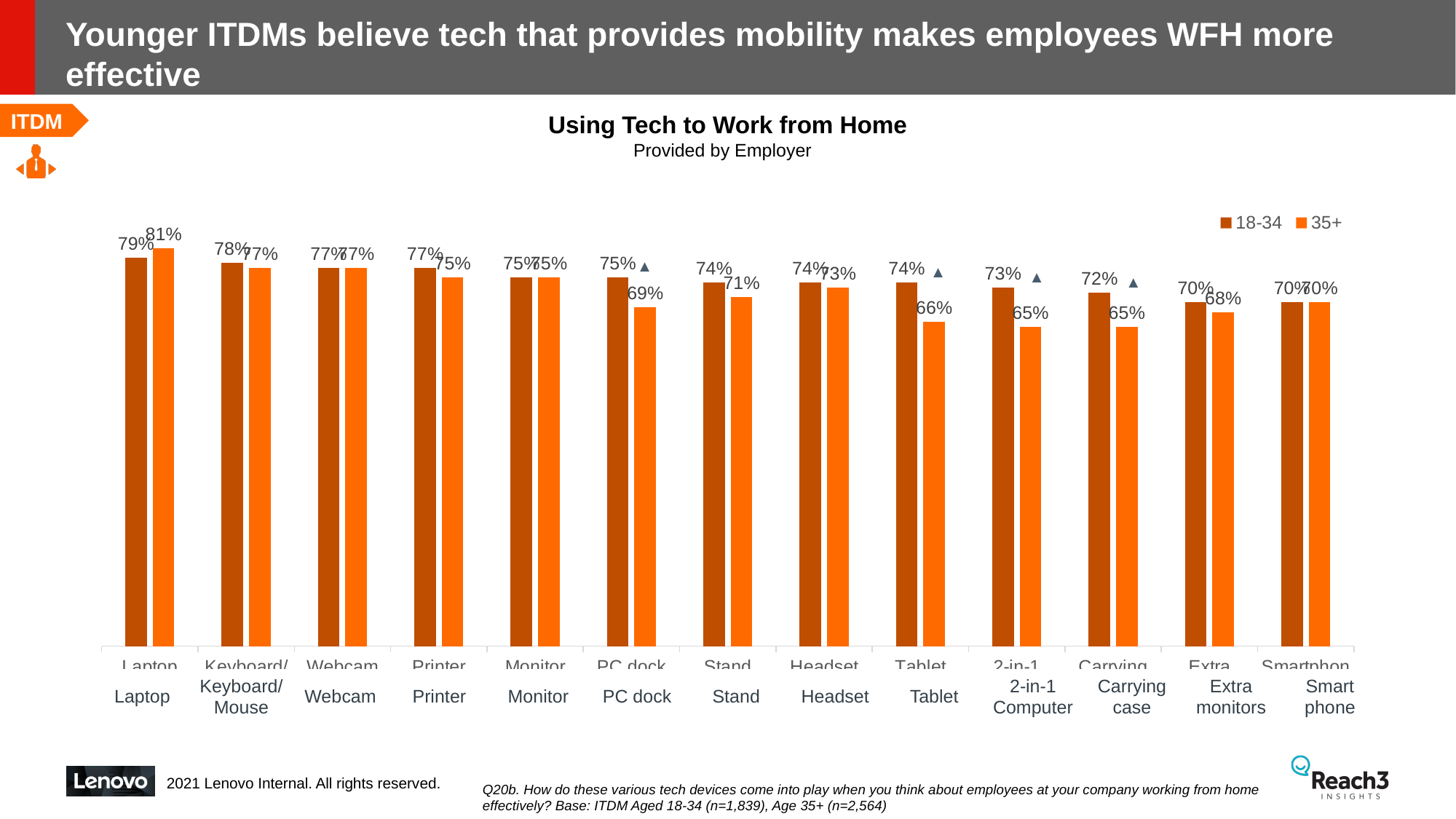
What is the value for the 18-34 group for Tablet? 74% What kind of chart is shown on the slide? Bar chart How many series does the legend list? 2 What is the difference between the 18-34 and 35+ values for Tablet? 8 percentage points What is the value for the 35+ group for 2-in-1 Computer? 65% How many device categories are shown on the x axis? 13 Which category has the highest value for the 35+ group? Laptop Which category has the highest value for the 18-34 group? Laptop What is the value for the 35+ group for Laptop? 81% For Laptop, which group has the larger value, 18-34 or 35+? 35+ What is the difference between the 18-34 and 35+ values for PC dock? 6 percentage points What is the value for the 35+ group for PC dock? 69%